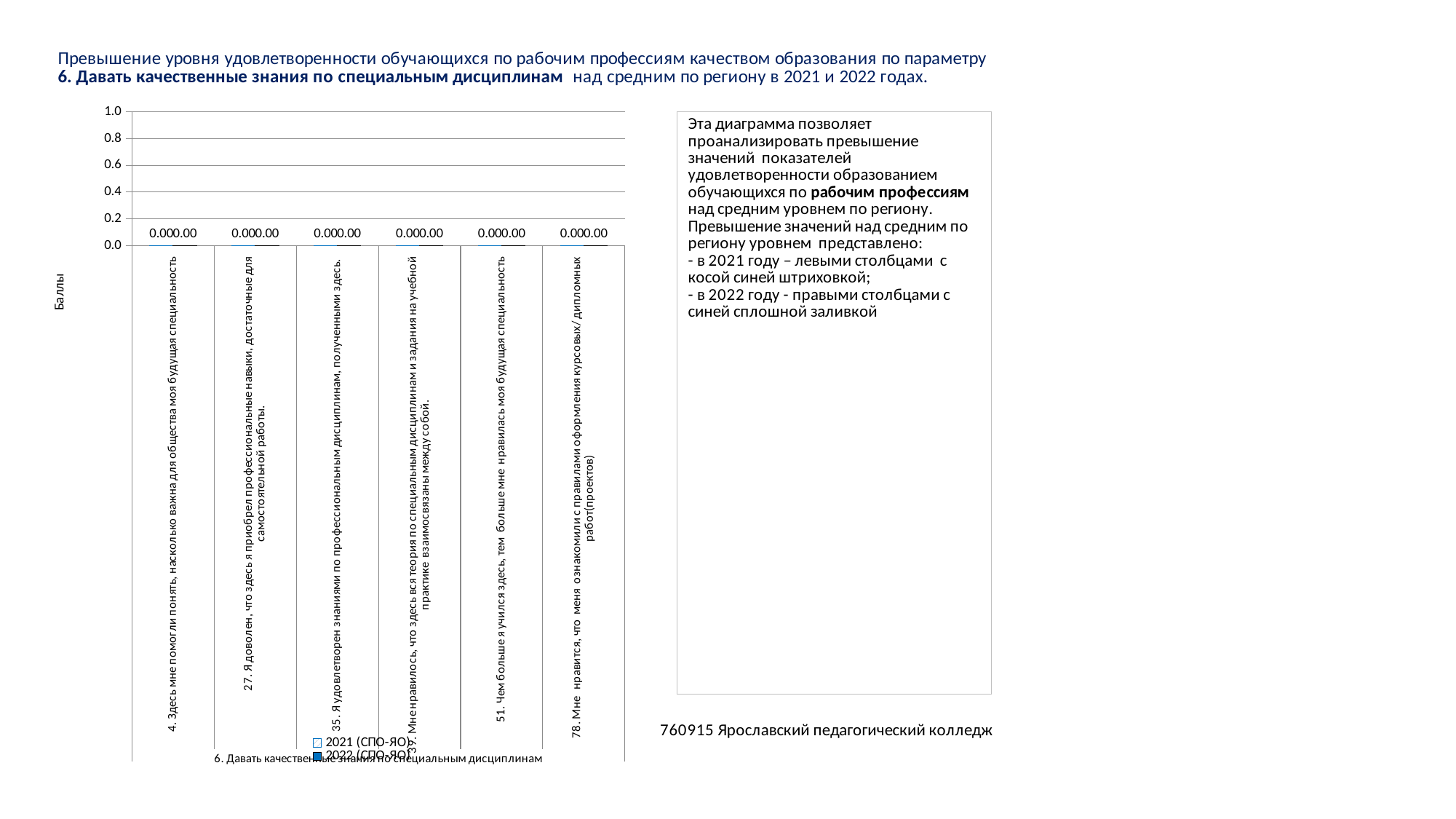
Is the value for '51. Чем больше я учился здесь, тем больше мне нравилась моя будущая специальность' greater or less than 0.4? less What data label is printed above the category '4. Здесь мне помогли понять, насколько важна для общества моя будущая специальность'? 0.00 What is the difference between the data labels printed for category '4. Здесь мне помогли понять, насколько важна для общества моя будущая специальность' and category '35. Я удовлетворен знаниями по профессиональным дисциплинам, полученными здесь.'? 0.00 What is the label of the vertical axis of the chart? Баллы What is the highest tick value shown on the vertical axis of the chart? 1.0 What kind of chart is shown on the slide? bar chart What data label is printed above the category '78. Мне нравится, что меня ознакомили с правилами оформления курсовых/дипломных работ(проектов)'? 0.00 How many series does the chart legend list? 2 Is the value for '27. Я доволен, что здесь я приобрел профессиональные навыки, достаточные для самостоятельной работы.' greater or less than 0.2? less How many categories are shown along the x axis of the chart? 6 What are the two series named in the chart legend? 2021 (СПО-ЯО) and 2022 (СПО-ЯО)